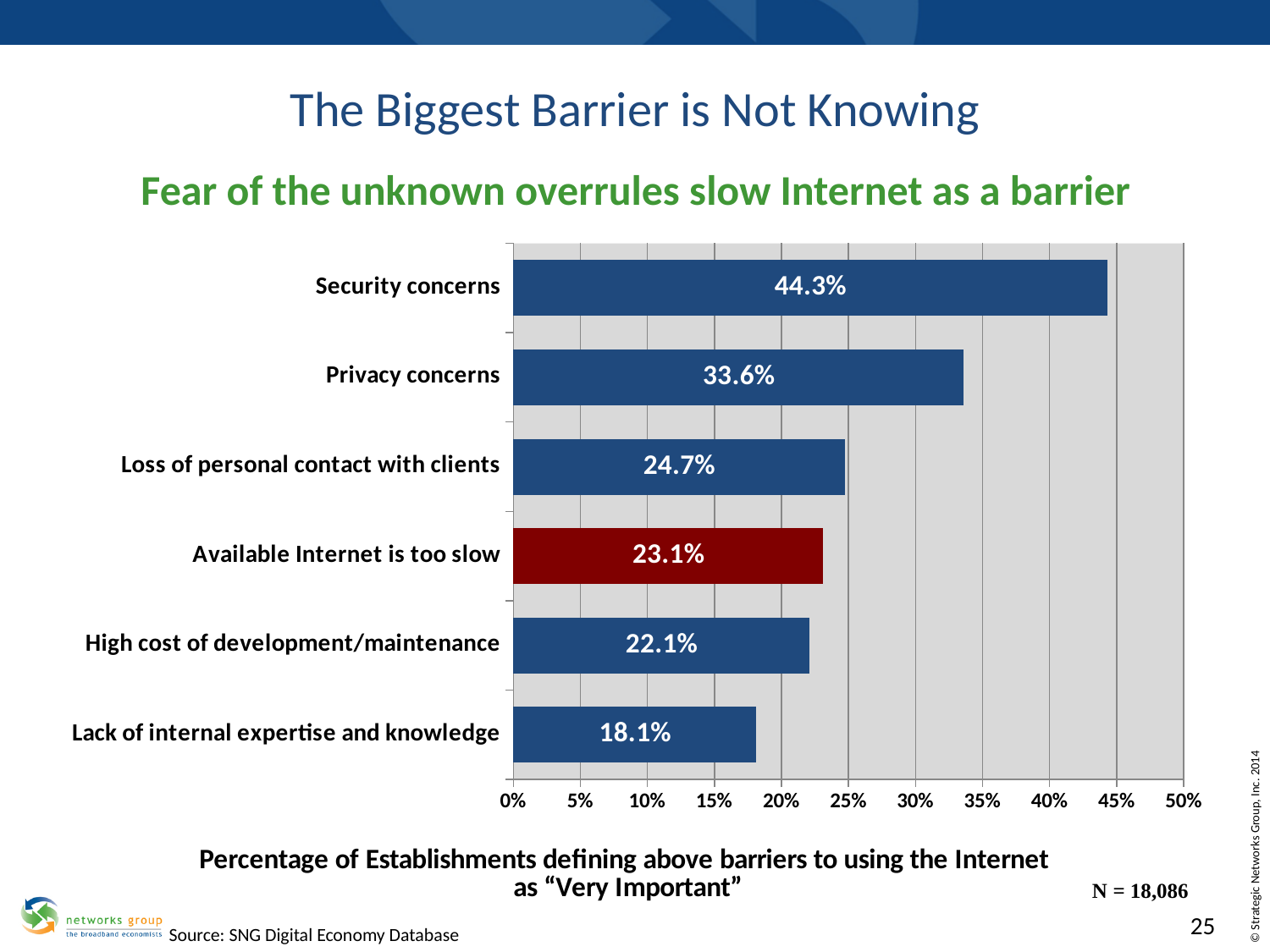
What is the value shown for Lack of internal expertise and knowledge? 18.1% Which barrier has the highest percentage? Security concerns What is the difference between Available Internet is too slow and High cost of development/maintenance? 1.0 percentage point What percentage of establishments rated Security concerns as a "Very Important" barrier? 44.3% What is the value shown for Available Internet is too slow? 23.1% How many barriers are shown in the chart? 6 Which barrier has the lowest percentage? Lack of internal expertise and knowledge What kind of chart is shown on the slide? Bar chart Which is larger: Loss of personal contact with clients or Available Internet is too slow? Loss of personal contact with clients What is the sample size (N) stated on the slide? N = 18,086 Which bar is coloured red instead of blue? Available Internet is too slow What is the difference in percentage points between Security concerns and Privacy concerns? 10.7 percentage points